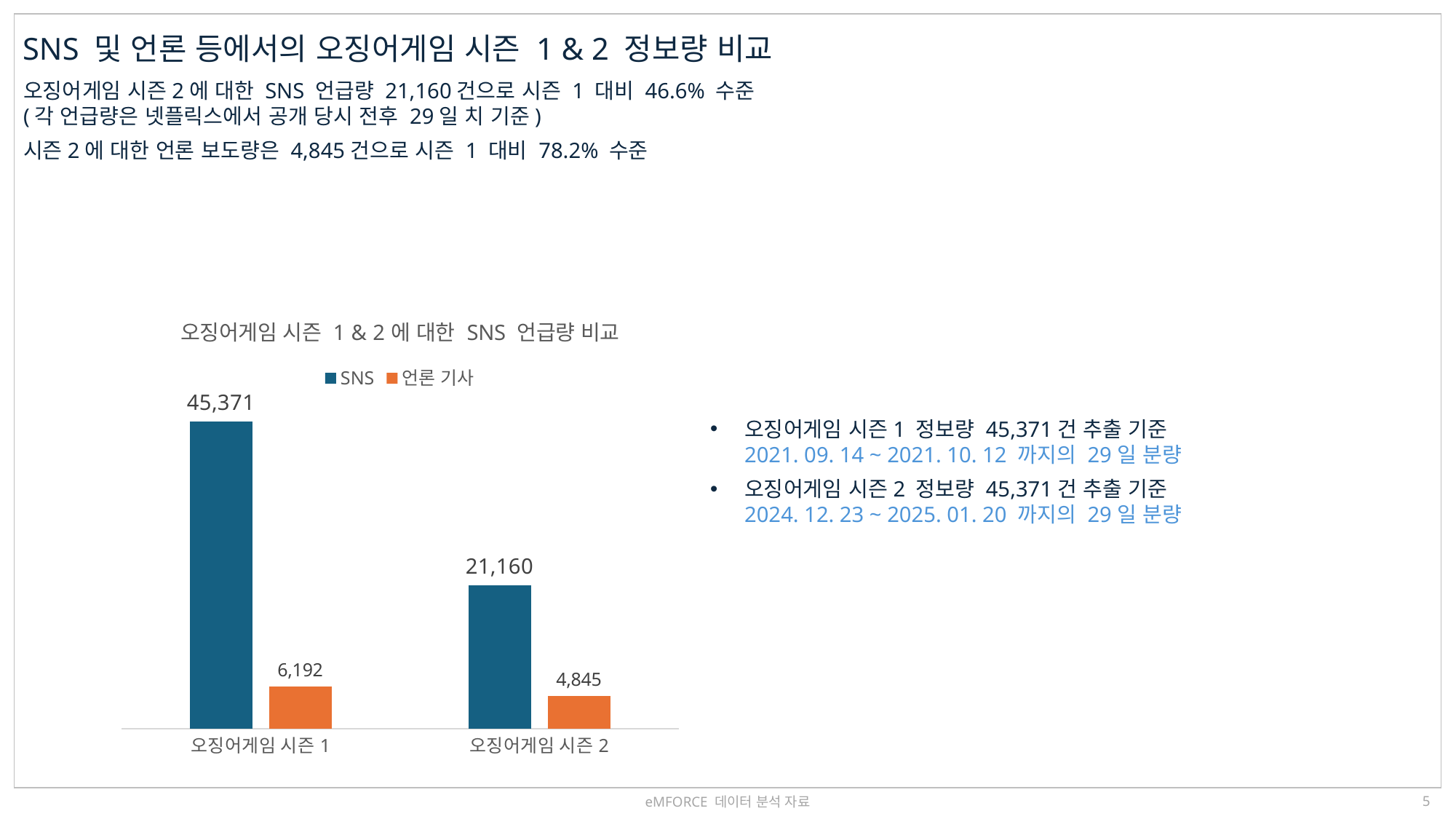
What kind of chart is shown on the slide? Bar chart Which category has the lowest 언론 기사 value? 오징어게임 시즌 2 What is the 언론 기사 value for 오징어게임 시즌 1? 6,192 What is the SNS value for 오징어게임 시즌 1? 45,371 What is the SNS value for 오징어게임 시즌 2? 21,160 How many series does the legend list? 2 Which category has the highest SNS value? 오징어게임 시즌 1 Which is larger: the SNS value for 오징어게임 시즌 2 or the 언론 기사 value for 오징어게임 시즌 1? SNS value for 오징어게임 시즌 2 What is the 언론 기사 value for 오징어게임 시즌 2? 4,845 What is the difference between the SNS values for 오징어게임 시즌 1 and 오징어게임 시즌 2? 24,211 How many categories are shown on the x axis? 2 What is the difference between the 언론 기사 values for 오징어게임 시즌 1 and 오징어게임 시즌 2? 1,347